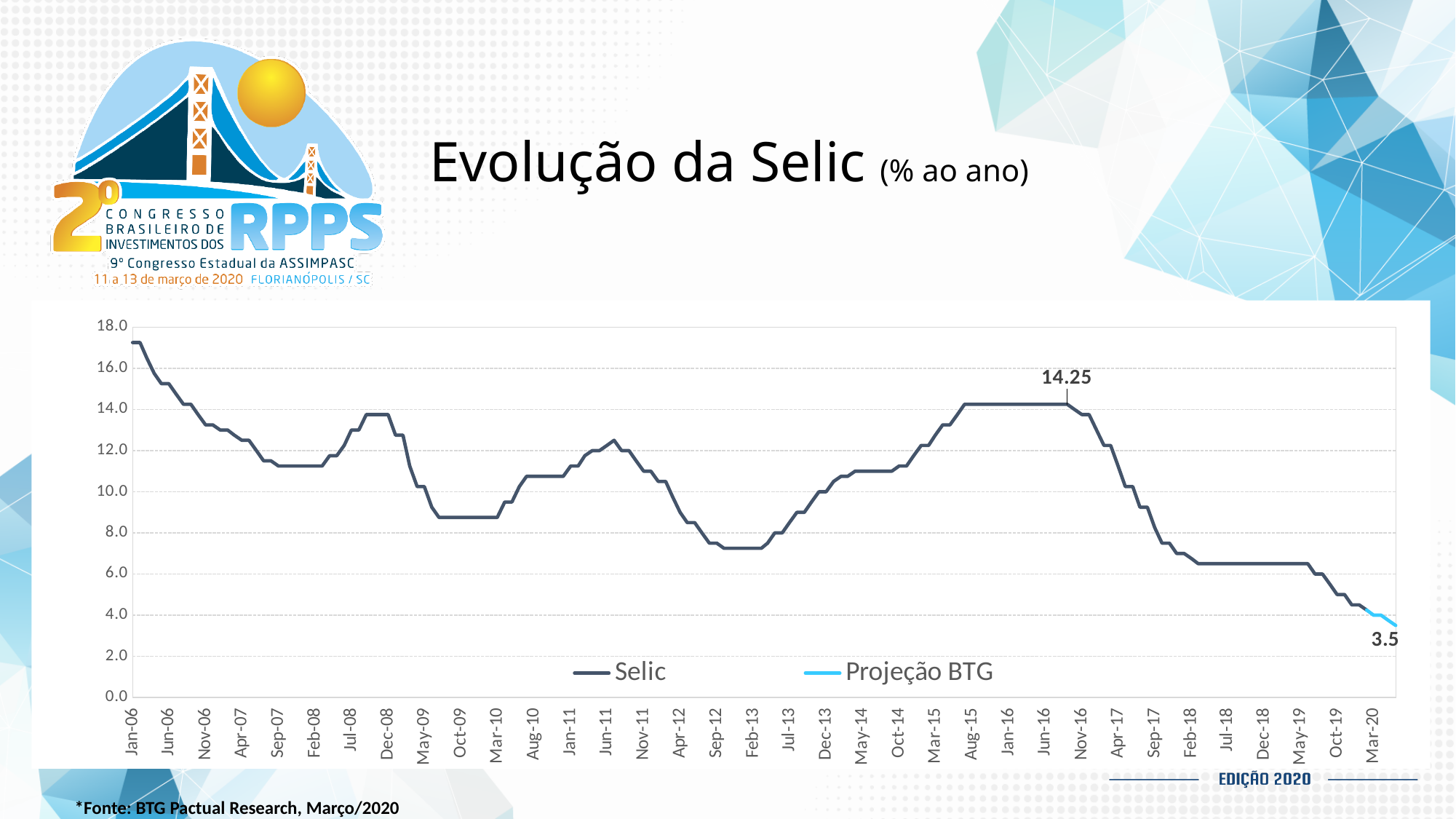
Does the Selic line rise or fall between Nov-16 and Mar-20? fall Is the Selic value at Jan-06 greater or less than 16.0? greater What is the title of the chart on the slide? Evolução da Selic (% ao ano) Is the Selic value at Sep-12 greater or less than 8.0? less What are the two series named in the chart legend? Selic and Projeção BTG What is the difference between the labelled value 14.25 and the labelled projected value 3.5? 10.75 What value is labelled at the end of the Projeção BTG line? 3.5 Is the Selic value at Oct-09 greater or less than 10.0? less How many series does the chart legend list? 2 What value is labelled at the plateau of the Selic line around Jun-16? 14.25 At which x-axis label does the Selic line reach its highest value? Jan-06 What kind of chart is shown on the slide? line chart